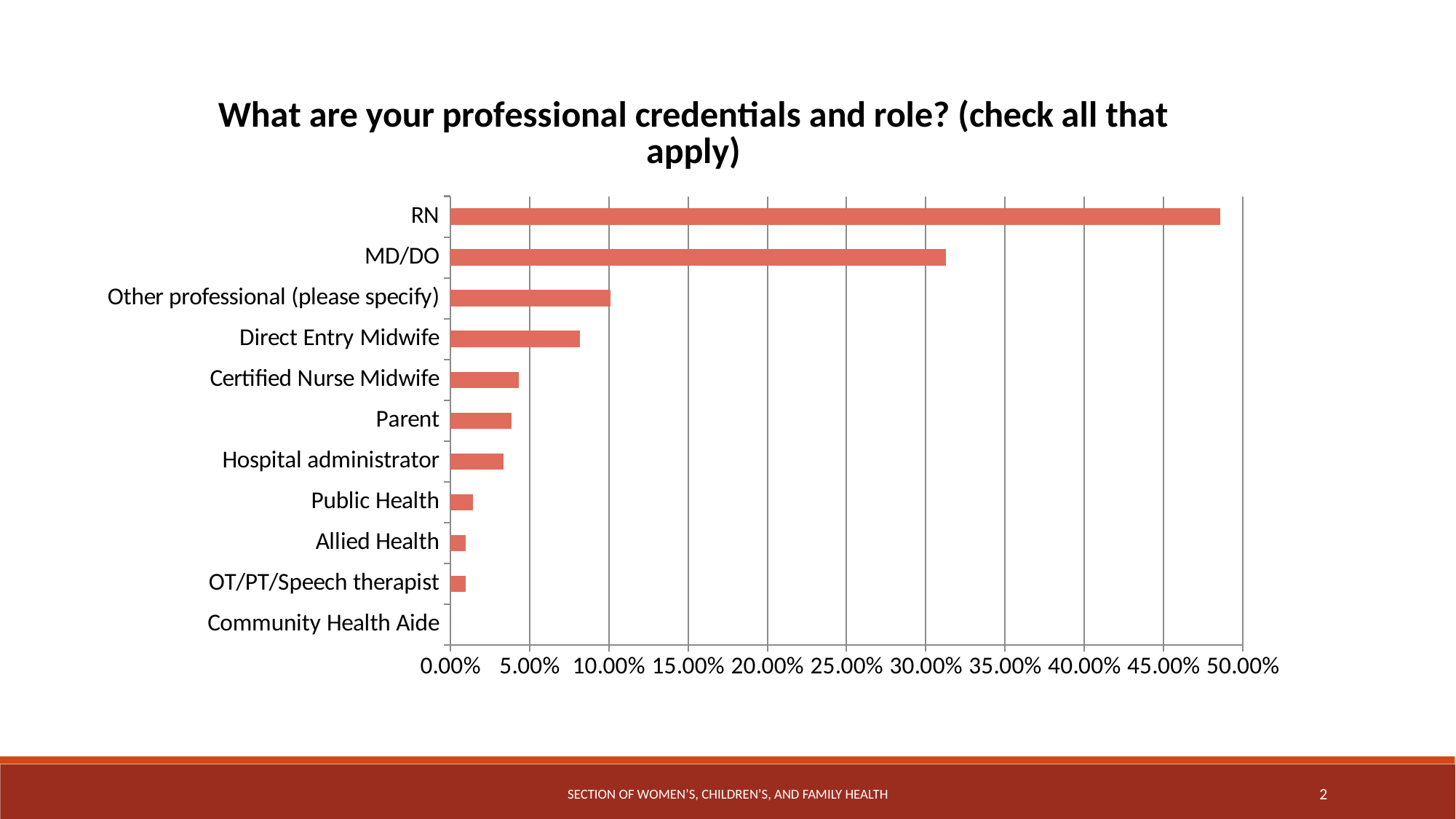
Is the value for Direct Entry Midwife greater or less than 10.00%? less What is the title of the chart? What are your professional credentials and role? (check all that apply) How many professional credential or role categories are shown on the chart? 11 Is the value for Certified Nurse Midwife greater or less than 5.00%? less Which is larger, the value for Parent or the value for Public Health? Parent Is the value for RN greater or less than 45.00%? greater Which professional credential or role has the highest value? RN What kind of chart is shown on the slide? Bar chart Which professional credential or role has the lowest value? Community Health Aide Which is larger, the value for RN or the value for MD/DO? RN